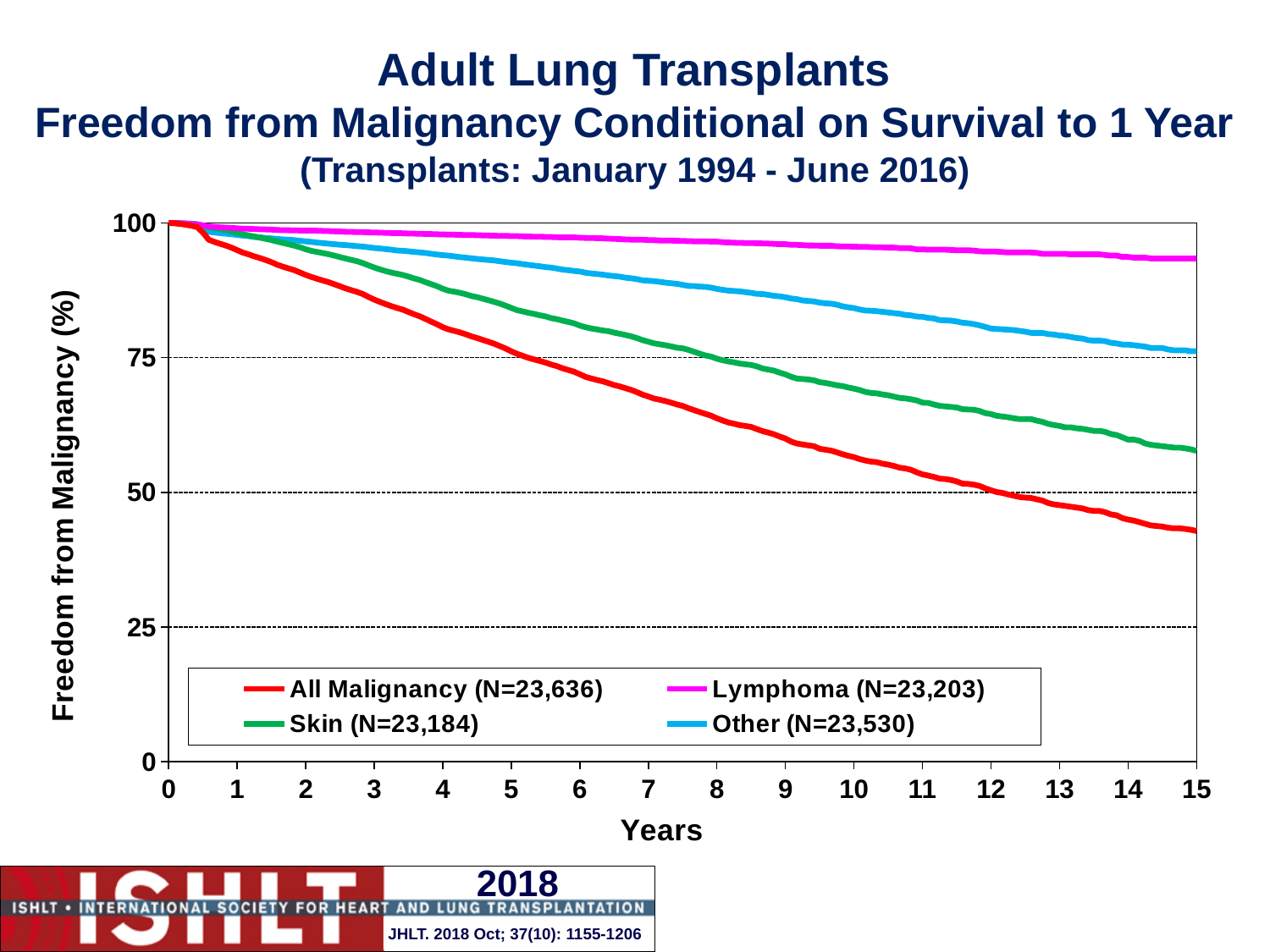
Is the value for Lymphoma at 15 years greater or less than 75? greater Do the values for All Malignancy rise or fall as the years increase? fall What is the N value shown in the legend for the Skin series? 23,184 Which series has the highest freedom from malignancy at 15 years? Lymphoma How many series does the legend list? 4 At 15 years, which series has the higher freedom from malignancy, Lymphoma or Skin? Lymphoma What kind of chart is shown on the slide? line chart Is the value for All Malignancy at 7 years greater or less than 75? less Is the value for All Malignancy at 15 years greater or less than 50? less Which series has the lowest freedom from malignancy at 15 years? All Malignancy